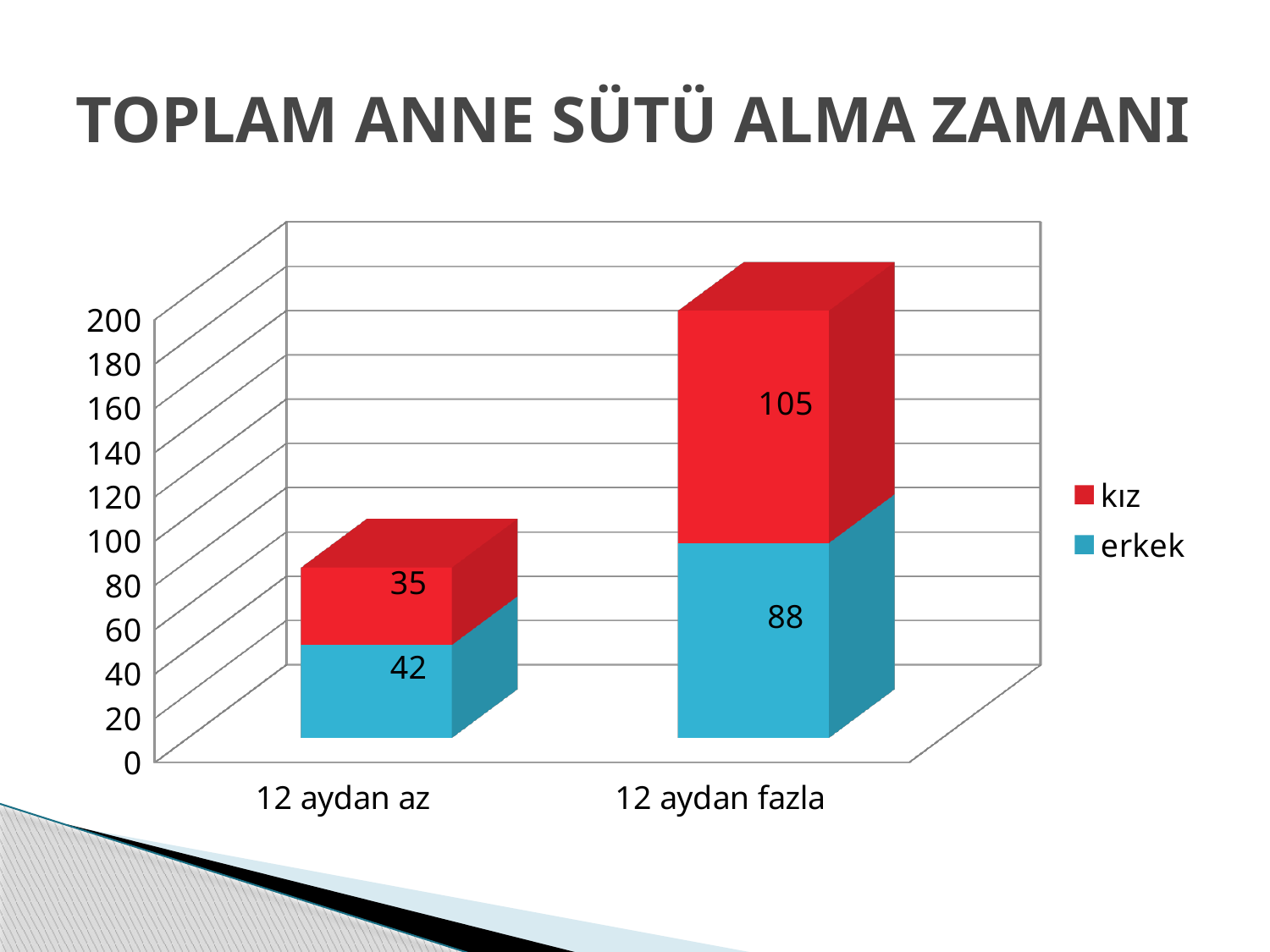
What is the value for erkek in the 12 aydan az category? 42 How many series does the legend list? 2 What kind of chart is shown on the slide? stacked bar chart What is the total of the stacked bar for 12 aydan fazla? 193 What is the value for erkek in the 12 aydan fazla category? 88 Which category has the higher total? 12 aydan fazla Which is larger: the erkek value for 12 aydan az or the kız value for 12 aydan az? erkek What is the difference between the kız values for 12 aydan fazla and 12 aydan az? 70 What is the value for kız in the 12 aydan fazla category? 105 What is the value for kız in the 12 aydan az category? 35 How many categories are shown on the x axis? 2 What is the total of the stacked bar for 12 aydan az? 77